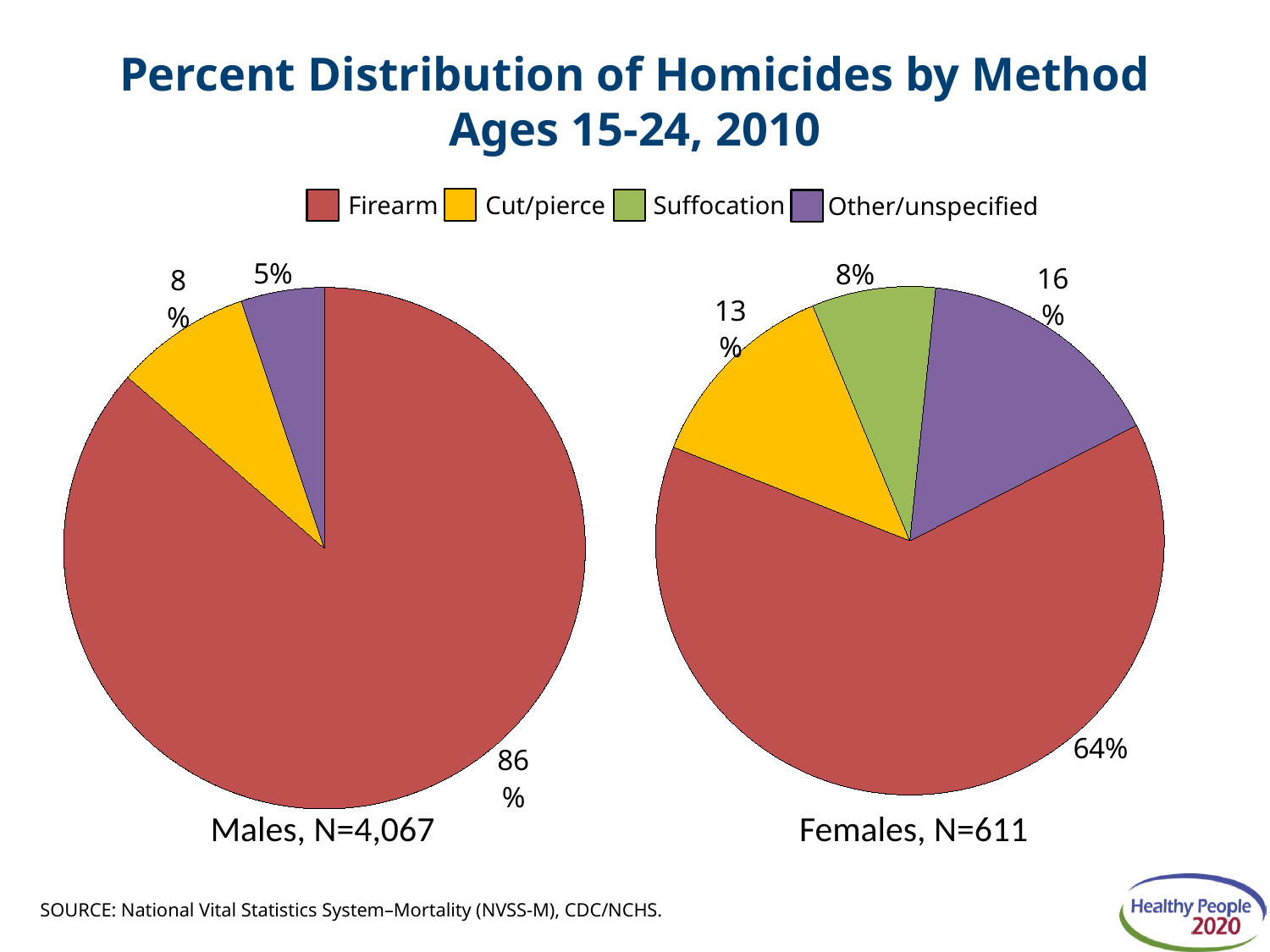
What is the difference between the firearm share in the Males pie chart and the firearm share in the Females pie chart? 22 percentage points In the Males pie chart, what percentage of homicides were by firearm? 86% In the Females pie chart, which method has the smallest slice? Suffocation In the Males pie chart, what share is labelled for Cut/pierce? 8% In the Females pie chart, what percentage of homicides were by firearm? 64% How many series does the legend list? 4 In the Females pie chart, what share is labelled for Other/unspecified? 16% What is the N value given for the Females pie chart? 611 In the Males pie chart, which method has the largest slice? Firearm What kind of charts are shown on the slide? Pie charts Which is larger: the Cut/pierce share in the Females pie chart or the Cut/pierce share in the Males pie chart? Females In the Females pie chart, what share is labelled for Suffocation? 8%